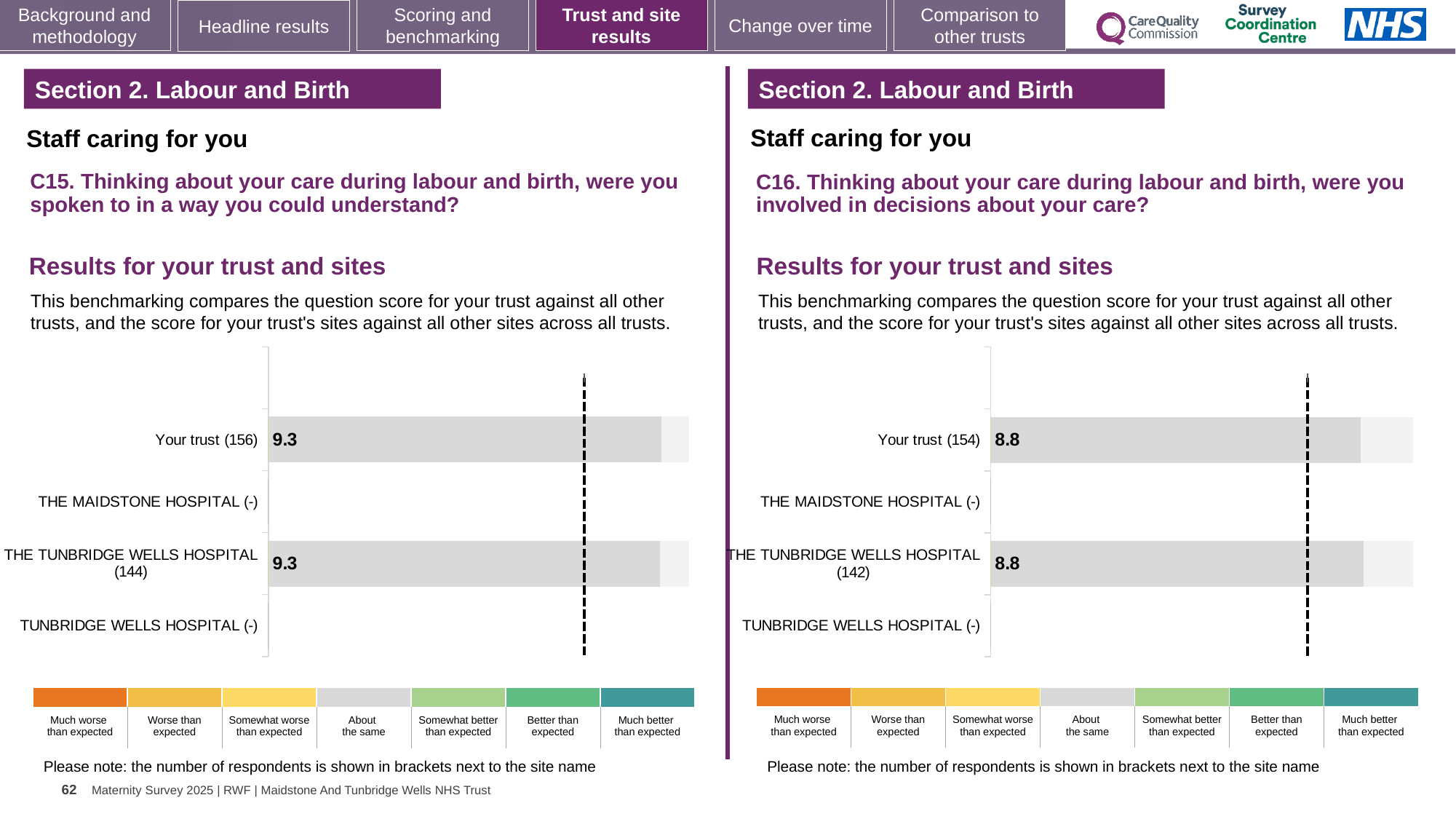
In the C15 chart on the left, what is the difference between the score for Your trust and the score for The Tunbridge Wells Hospital? 0 In the C16 chart on the right, what is the score for Your trust? 8.8 In the C15 chart on the left, what is the score for Your trust? 9.3 How many site/trust categories are listed on the y axis of the C15 chart on the left? 4 In the C15 chart on the left, how many respondents are shown in brackets for Your trust? 156 In the C16 chart on the right, what is the difference between the score for Your trust and the score for The Tunbridge Wells Hospital? 0 In the C16 chart on the right, how many respondents are shown in brackets for The Tunbridge Wells Hospital? 142 Is the score for Your trust in the C16 chart on the right greater or less than the score for Your trust in the C15 chart on the left? less How many site/trust categories are listed on the y axis of the C16 chart on the right? 4 In the C15 chart on the left, what is the score for The Tunbridge Wells Hospital? 9.3 What kind of chart is the C15 chart on the left? Bar chart In the C16 chart on the right, what is the score for The Tunbridge Wells Hospital? 8.8